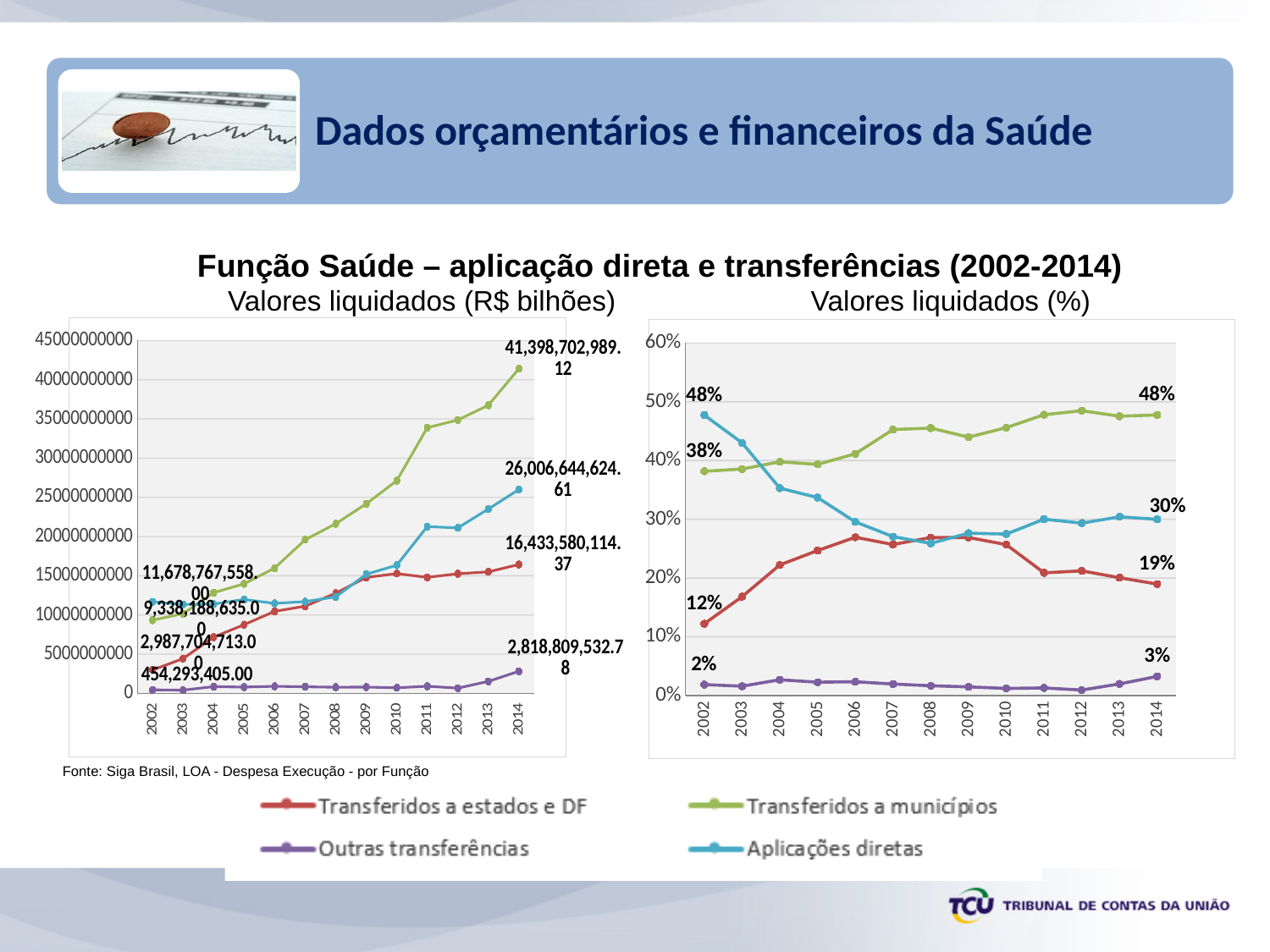
In the 'Valores liquidados (R$ bilhões)' chart, which series has the highest value in 2014? Transferidos a municípios How many years are plotted on the x axis of the 'Valores liquidados (R$ bilhões)' chart? 13 In the 'Valores liquidados (%)' chart, what is the value for Transferidos a municípios in 2014? 48% In the 'Valores liquidados (R$ bilhões)' chart, what is the value for Transferidos a municípios in 2014? 41,398,702,989.12 In the 'Valores liquidados (%)' chart, what is the value for Aplicações diretas in 2002? 48% In the 'Valores liquidados (R$ bilhões)' chart, what is the value for Outras transferências in 2002? 454,293,405.00 How many series does the legend list? 4 In the 'Valores liquidados (%)' chart, which series has the lowest value in 2014? Outras transferências What type of chart is the 'Valores liquidados (%)' chart on the right? line chart In the 'Valores liquidados (%)' chart, does the Transferidos a municípios series rise or fall from 2002 to 2014? rise In the 'Valores liquidados (%)' chart, by how many percentage points did Aplicações diretas fall from 2002 to 2014? 18% In the 'Valores liquidados (%)' chart, what is the value for Transferidos a estados e DF in 2014? 19%